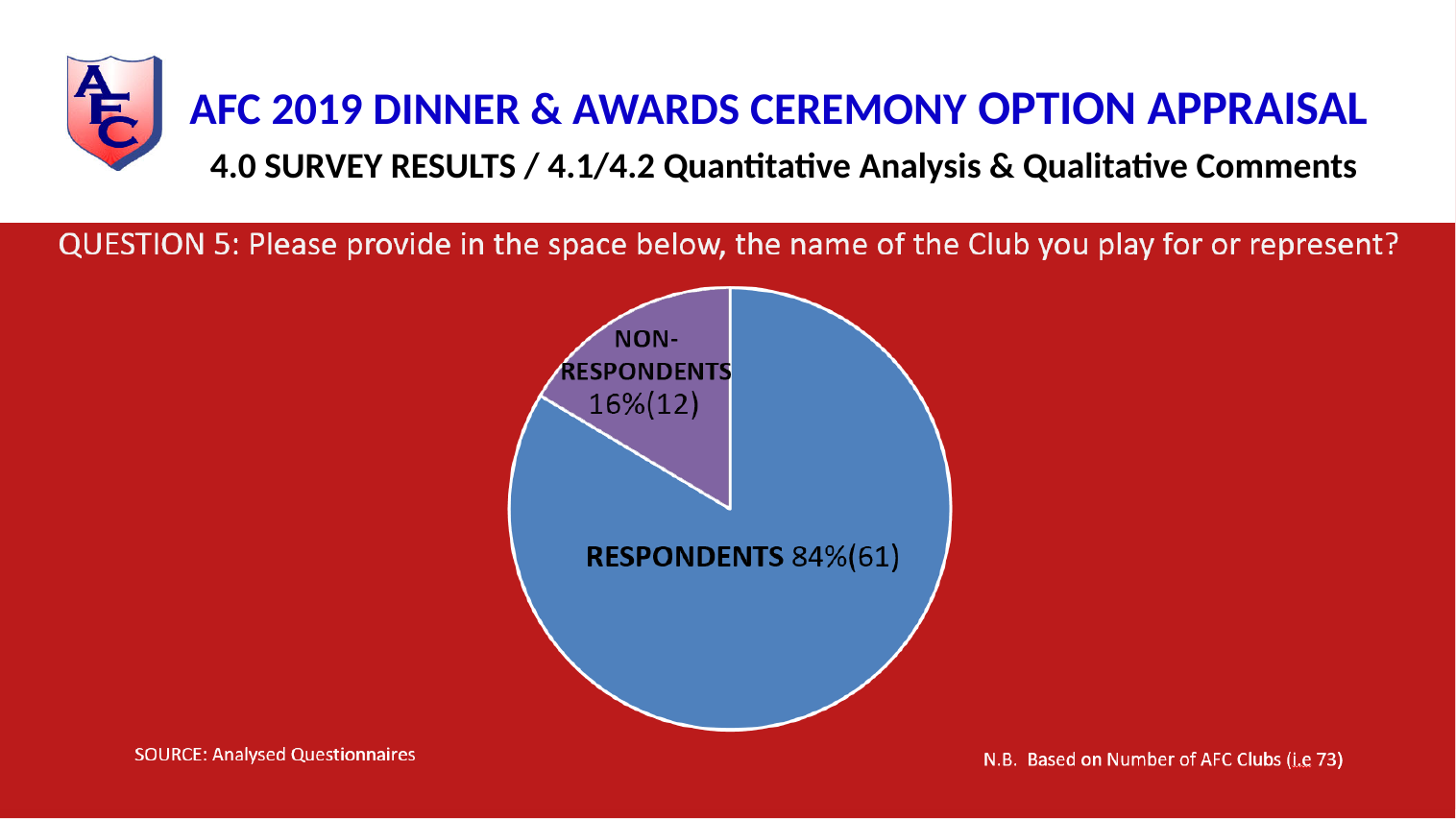
Which slice of the pie is the smallest? NON-RESPONDENTS How many respondents are shown in the RESPONDENTS slice? 61 Which is larger, the RESPONDENTS slice or the NON-RESPONDENTS slice? RESPONDENTS What is the difference in count between the RESPONDENTS and NON-RESPONDENTS slices? 49 How many are shown in the NON-RESPONDENTS slice? 12 What kind of chart is shown on the slide? pie chart How many slices does the pie chart have? 2 What colour is the RESPONDENTS slice of the pie? blue What percentage of the pie is labelled RESPONDENTS? 84% Which slice of the pie is the largest? RESPONDENTS What percentage of the pie is labelled NON-RESPONDENTS? 16% What is the difference in percentage points between the RESPONDENTS and NON-RESPONDENTS slices? 68